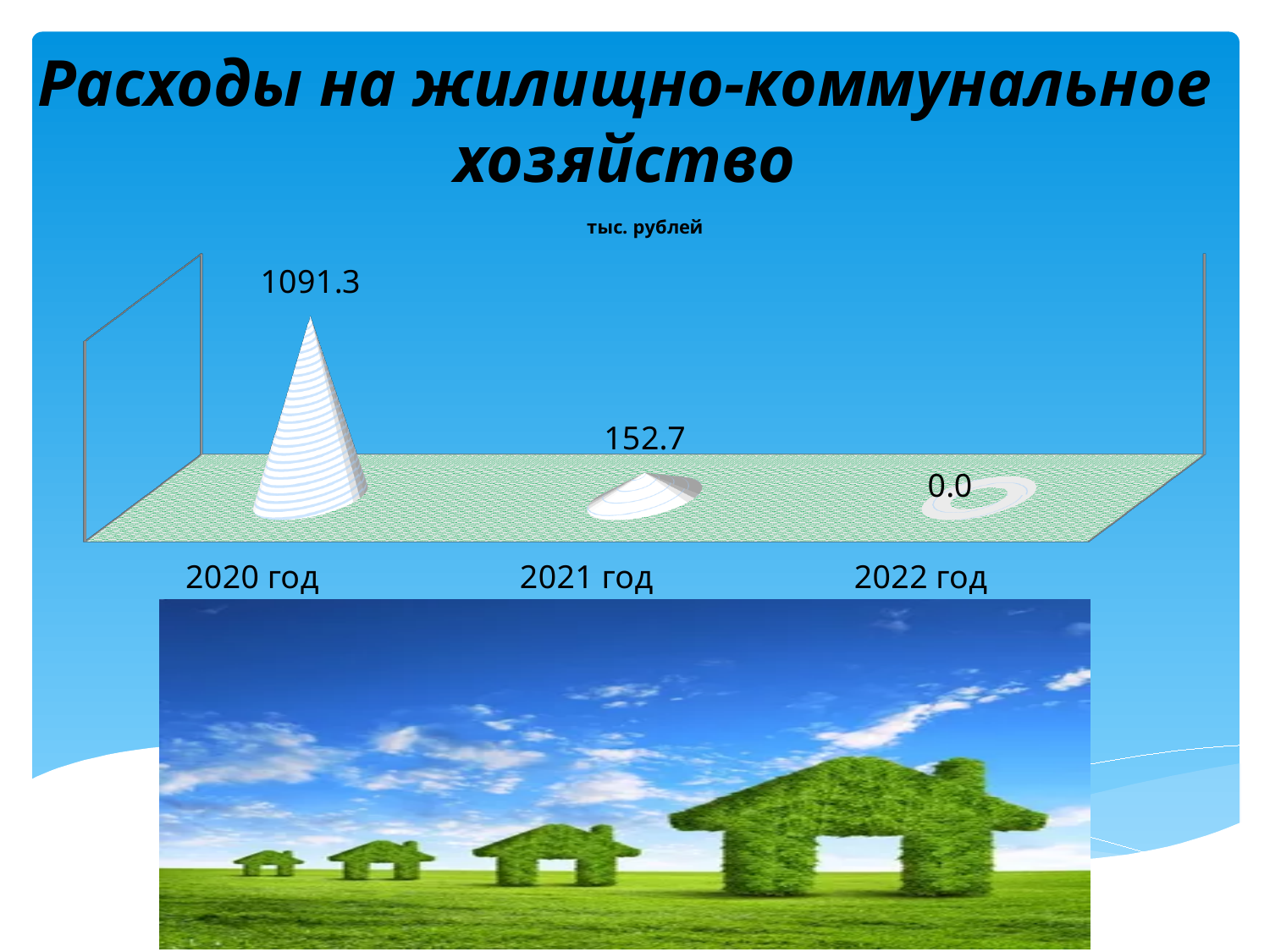
What is the value for 2020 год? 1091.3 Which year has the lowest value? 2022 год What is the difference between the values for 2021 год and 2022 год? 152.7 Which is larger, the value for 2020 год or the value for 2021 год? 2020 год How many years are shown on the chart? 3 In what units are the values on the chart given? тыс. рублей What is the value for 2021 год? 152.7 Which year has the highest value? 2020 год Do the values rise or fall from 2020 год to 2022 год? fall What is the value for 2022 год? 0.0 What is the difference between the values for 2020 год and 2021 год? 938.6 What is the title of the chart? тыс. рублей